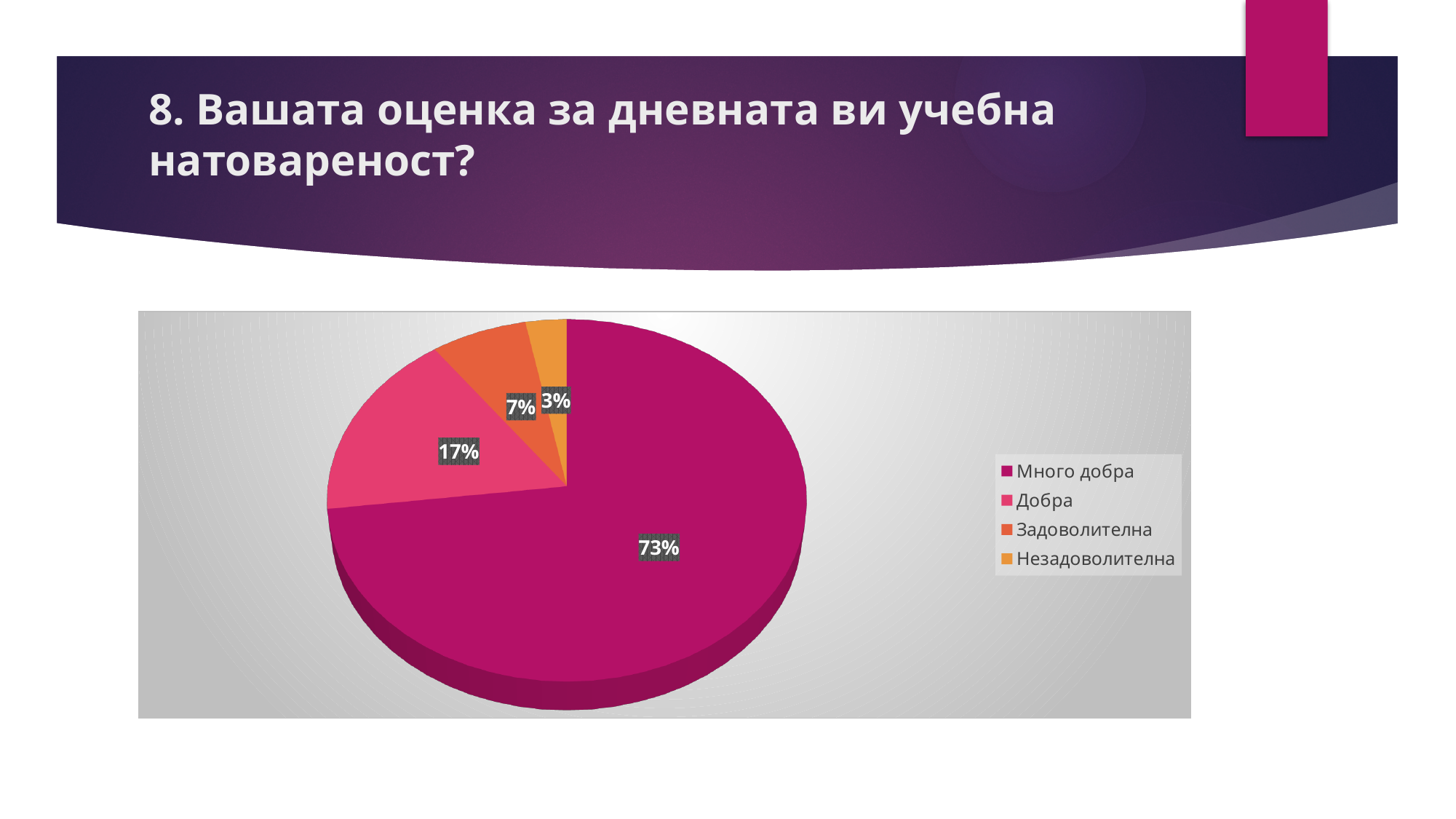
What is the difference between the shares of "Много добра" and "Добра"? 56% What colour is the slice for "Незадоволителна"? orange How many categories does the pie chart have? 4 Which is larger, the share for "Добра" or the share for "Задоволителна"? Добра Which category has the smallest slice of the pie? Незадоволителна What is the difference between the shares of "Задоволителна" and "Незадоволителна"? 4% What share of the pie does "Задоволителна" have? 7% What share of the pie does "Добра" have? 17% Which category has the largest slice of the pie? Много добра What kind of chart is shown on the slide? pie chart What share of the pie does "Незадоволителна" have? 3%